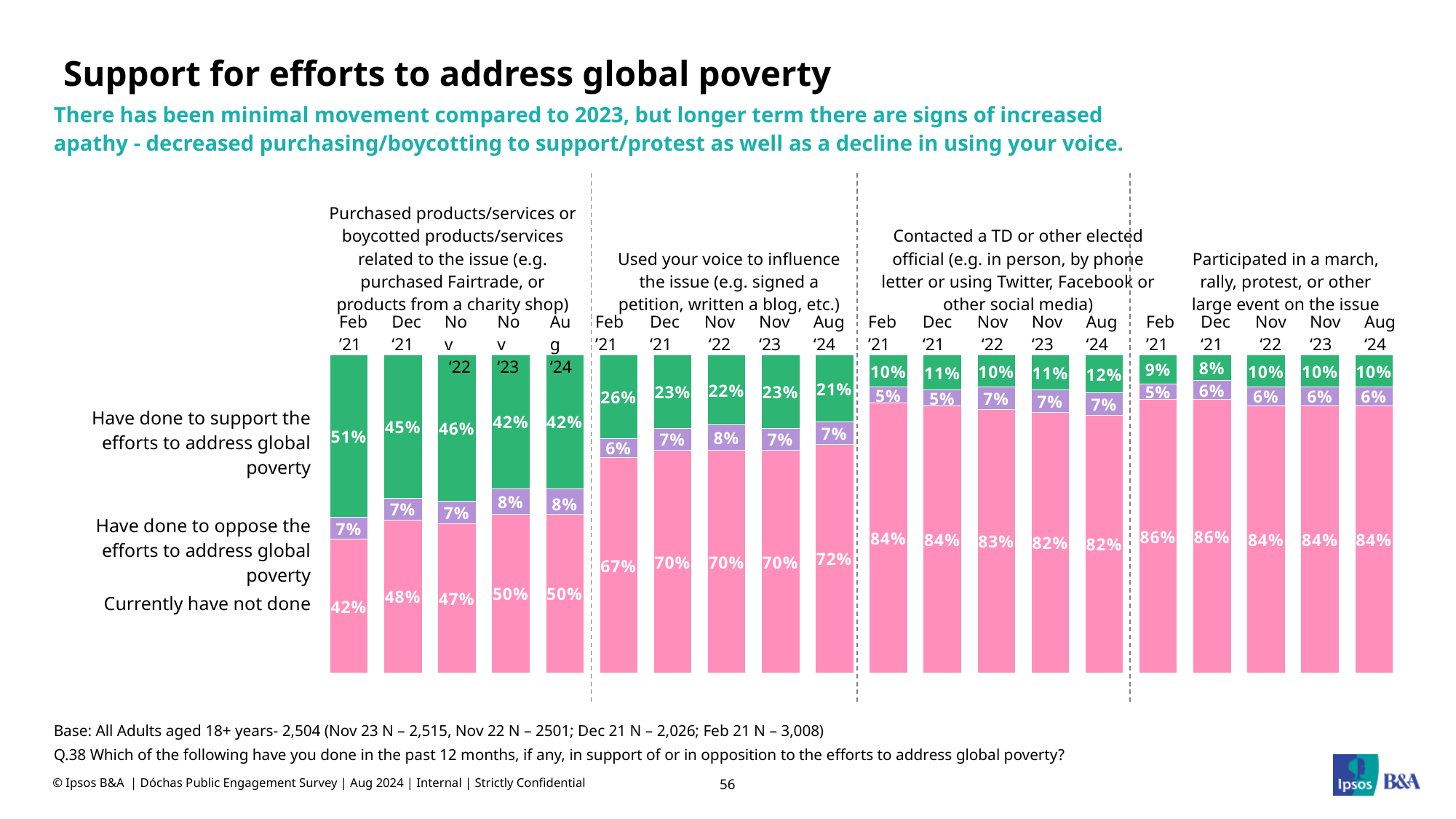
What percentage had done something to support the efforts in Aug '24 for 'Purchased products/services or boycotted products/services related to the issue'? 42% In the 'Used your voice to influence the issue' section, does the 'Currently have not done' share rise or fall from Feb '21 to Aug '24? Rise What is the 'Have done to support' value for Aug '24 in the 'Contacted a TD or other elected official' section? 12% What type of chart is shown on the slide? Stacked bar chart What is the total of the three segments in the Feb '21 bar for 'Purchased products/services or boycotted products/services'? 100% In Feb '21, which activity had the larger 'Have done to support' share: 'Purchased products/services or boycotted products/services' or 'Used your voice to influence the issue'? Purchased products/services or boycotted products/services In the 'Used your voice to influence the issue' section, which time point has the lowest 'Have done to support' value? Aug '24 In the 'Purchased products/services or boycotted products/services' section, by how many percentage points did 'Have done to support' fall from Feb '21 to Aug '24? 9 percentage points How many series (response categories) are shown in the chart? 3 How many time points are shown for each activity? 5 In the 'Purchased products/services or boycotted products/services' section, which time point has the highest 'Have done to support' value? Feb '21 In the 'Used your voice to influence the issue' section, what percentage 'Currently have not done' in Feb '21? 67%